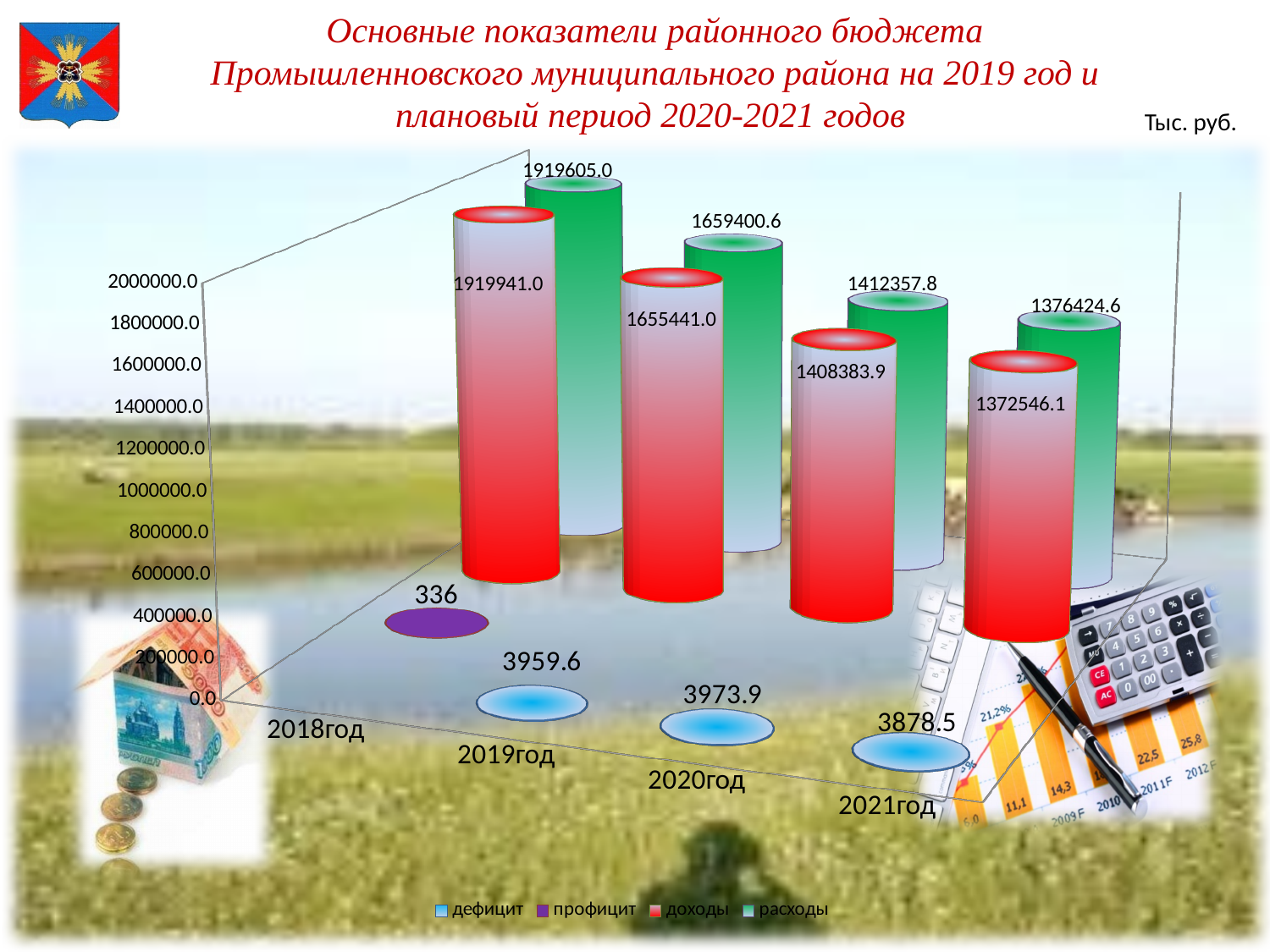
Which year has the highest value of доходы? 2018год How many series does the legend list? 4 What is the value of расходы for 2019год? 1659400.6 What is the value of доходы for 2018год? 1919941.0 Which is larger for 2019год: доходы or расходы? расходы How many years are shown on the x axis? 4 Do the values of доходы rise or fall from 2018год to 2021год? fall What is the value of профицит for 2018год? 336 Which year has the lowest value of расходы? 2021год What is the value of дефицит for 2020год? 3973.9 What is the difference between расходы and доходы for 2020год? 3973.9 What is the value of расходы for 2021год? 1376424.6